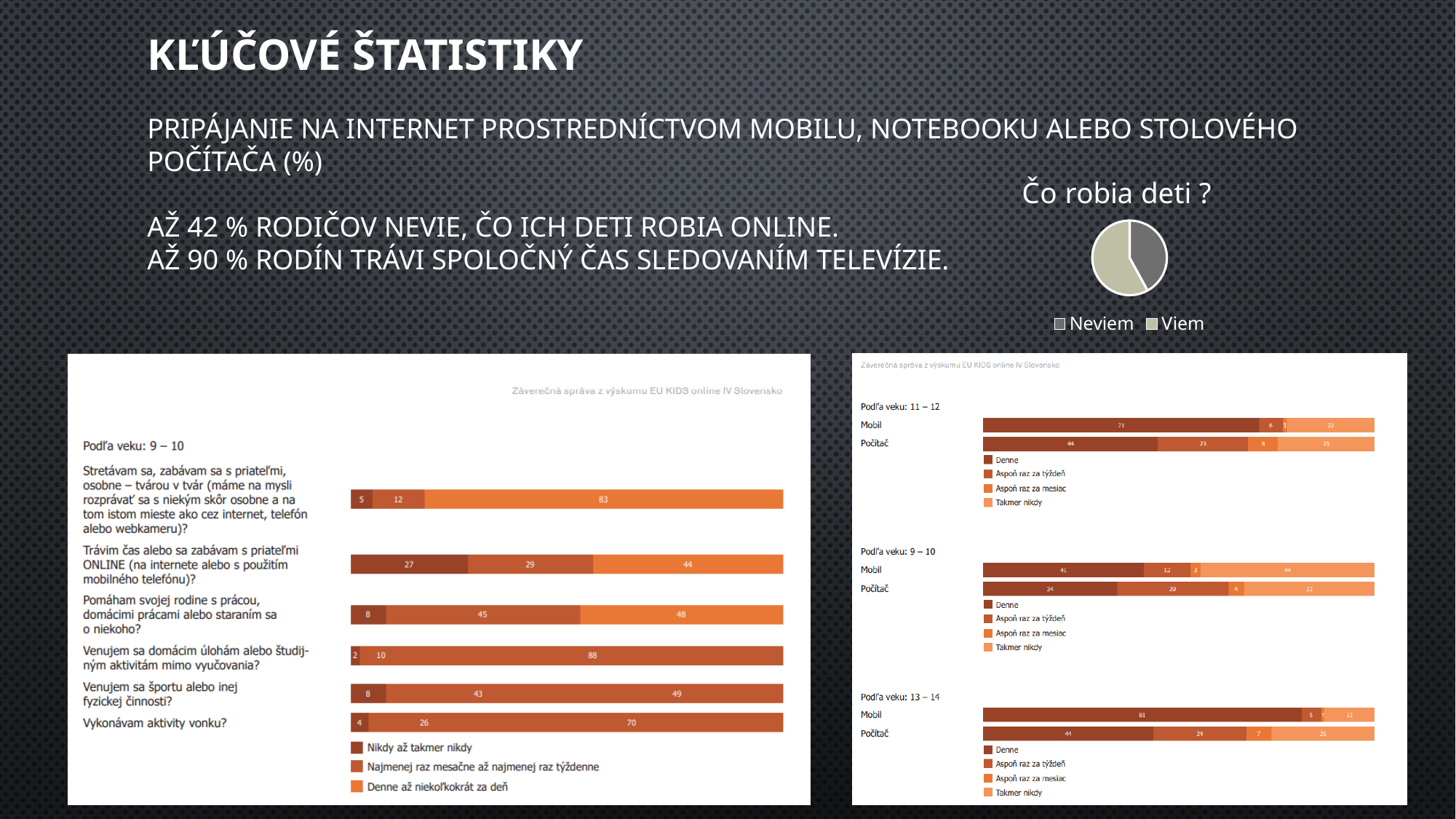
What kind of chart is the left chart titled 'Podľa veku: 9 – 10'? bar chart In the left chart 'Podľa veku: 9 – 10', how many activity categories are plotted? 6 In the right chart, how many series does the legend list for each age group? 4 What kind of chart is the 'Čo robia deti ?' chart? pie chart In the left chart 'Podľa veku: 9 – 10', what is the 'Denne až niekoľkokrát za deň' value for 'Vykonávam aktivity vonku?' 70 In the left chart 'Podľa veku: 9 – 10', what is the difference between the 'Denne až niekoľkokrát za deň' values for meeting friends in person (83) and spending time with friends online (44)? 39 In the 'Čo robia deti ?' pie chart, which slice is larger, Neviem or Viem? Viem How many entries does the legend of the 'Čo robia deti ?' pie chart list? 2 In the right chart, what is the 'Takmer nikdy' value for Počítač in the age group 9 – 10? 33 In the right chart, what is the 'Denne' value for Mobil in the age group 11 – 12? 71 In the right chart, what is the total of the Mobil bar for the age group 11 – 12? 100 In the left chart 'Podľa veku: 9 – 10', which activity has the highest 'Denne až niekoľkokrát za deň' value? Venujem sa domácim úlohám alebo študijným aktivitám mimo vyučovania?